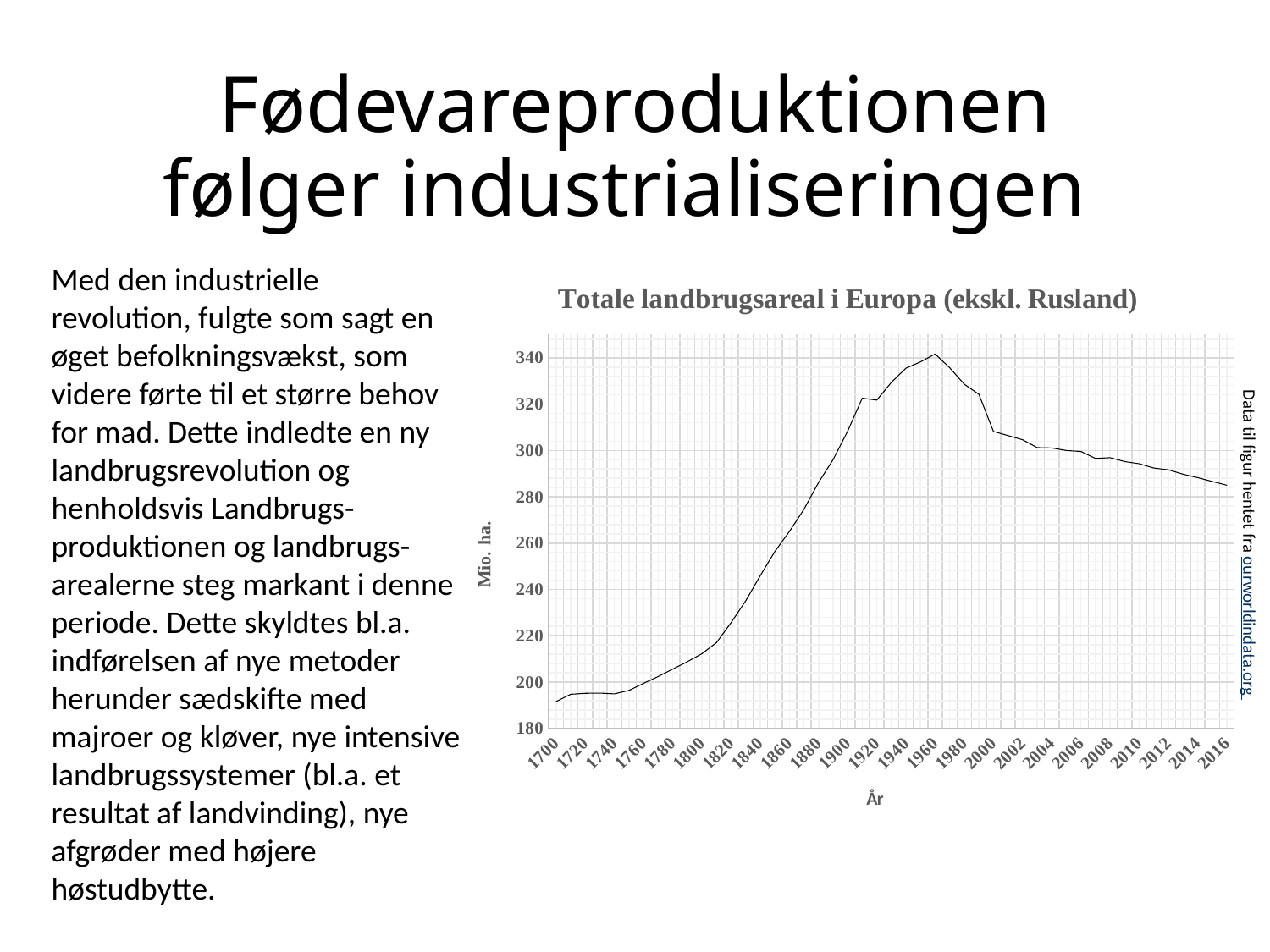
In which year does the line reach its highest value? 1960 Does the line rise or fall between 1700 and 1960? rise Is the value for 2016 greater or less than 300? less Which year has the larger value, 1920 or 2016? 1920 Is the value for 1960 greater or less than 320? greater What is the title of the chart? Totale landbrugsareal i Europa (ekskl. Rusland) In which year does the line have its lowest value? 1700 Does the line rise or fall between 1960 and 2016? fall What kind of chart is shown on the slide? line chart What is the label of the y axis of the chart? Mio. ha. Is the value for 1700 greater or less than 200? less